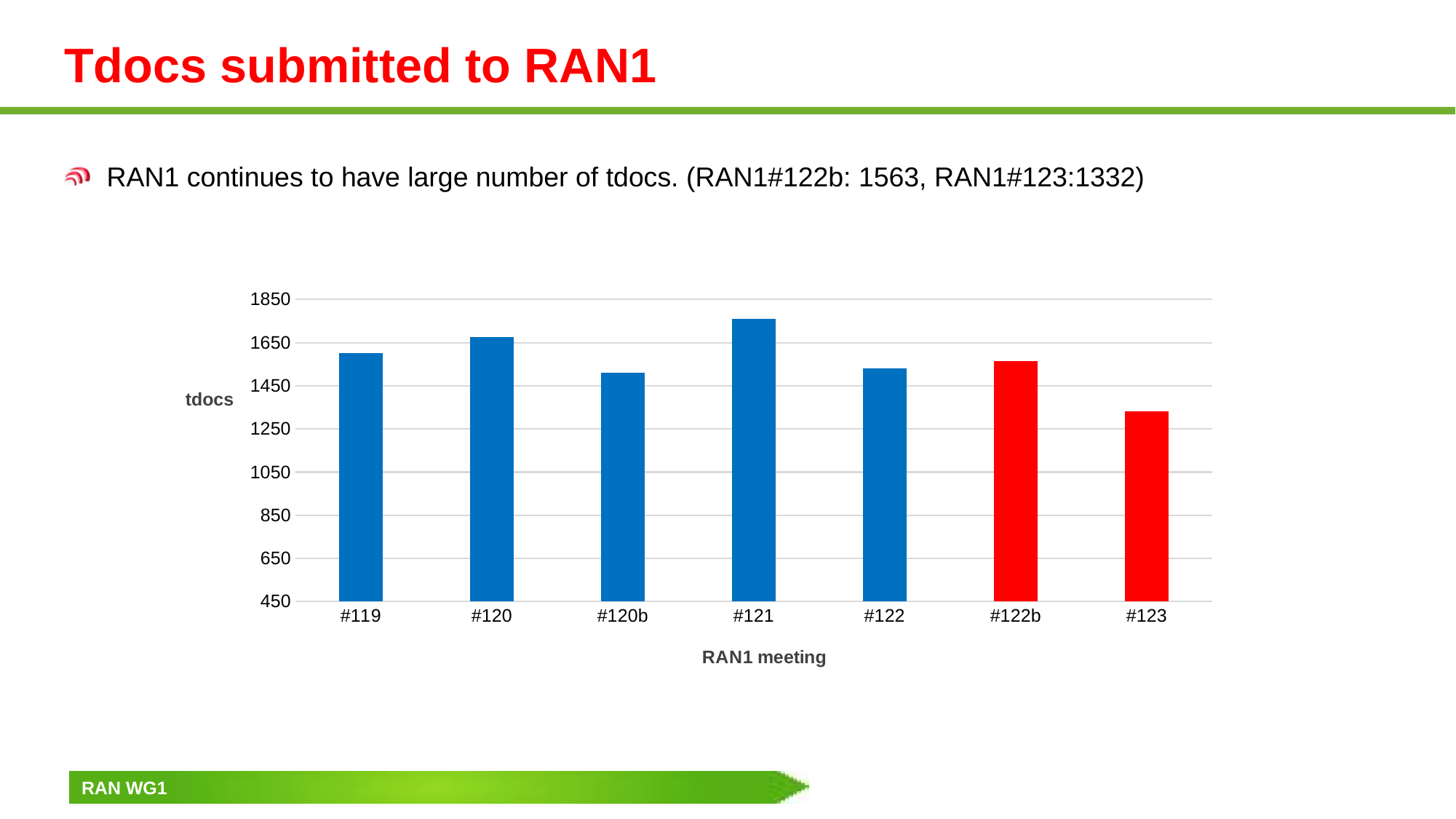
How many RAN1 meetings are shown on the x axis of the chart? 7 Which RAN1 meeting has the lowest number of tdocs in the chart? #123 What colour are the bars for #122b and #123? red What is the difference in tdocs between RAN1#122b and RAN1#123? 231 Which meeting has more tdocs, #120 or #122? #120 How many tdocs were submitted to RAN1#123? 1332 Which RAN1 meeting has the highest number of tdocs in the chart? #121 Is the number of tdocs for #121 greater or less than 1650? greater Is the number of tdocs for #120b greater or less than 1650? less What kind of chart is shown on the slide? bar chart What is the title of the x axis of the chart? RAN1 meeting How many tdocs were submitted to RAN1#122b? 1563